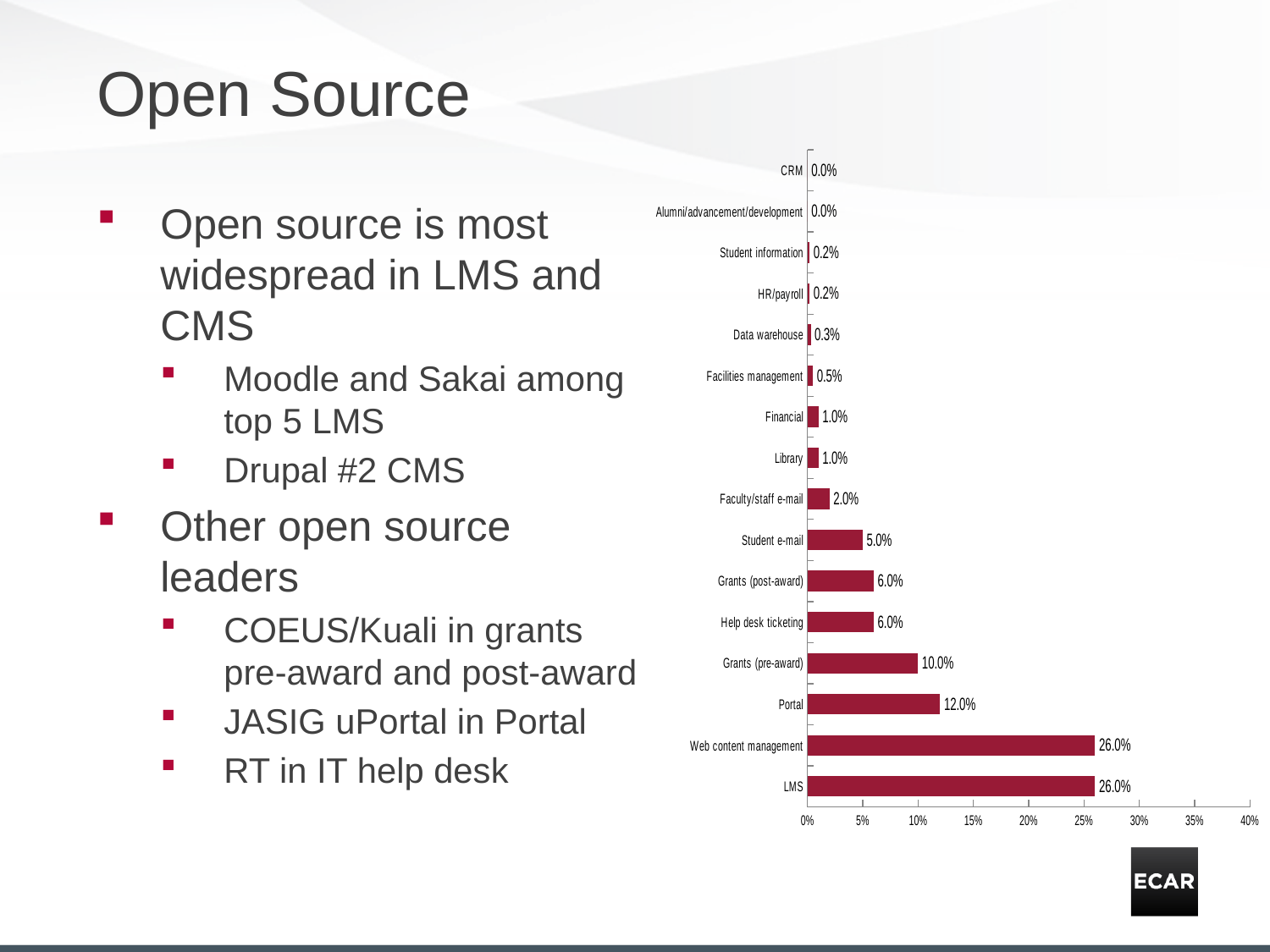
How many categories are shown in the chart? 16 What is the value for Grants (pre-award)? 10.0% What kind of chart is shown on the slide? bar chart What is the value for Facilities management? 0.5% Which is larger, the value for Grants (pre-award) or the value for Grants (post-award)? Grants (pre-award) Which is larger, the value for Student e-mail or the value for Faculty/staff e-mail? Student e-mail What is the value for LMS? 26.0% What is the value for Student e-mail? 5.0% Is the value for Web content management greater or less than 25%? greater What is the value for Portal? 12.0% What is the difference between the values for Portal and Grants (pre-award)? 2.0% What is the difference between the values for Web content management and Portal? 14.0%